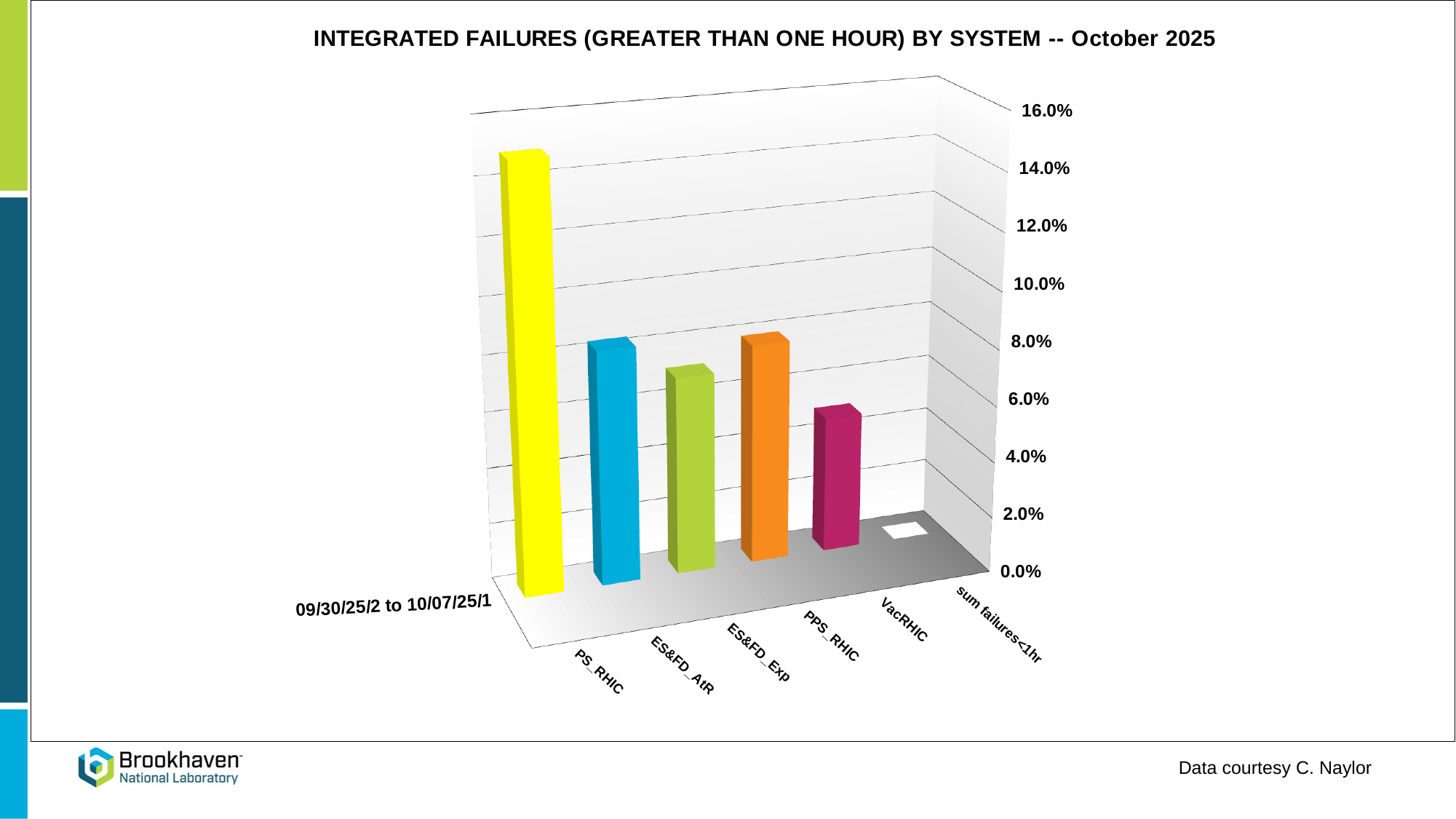
What kind of chart is shown on the slide? bar chart Which is larger, the value for ES&FD_AtR or the value for VacRHIC? ES&FD_AtR What date range is labelled on the chart's series axis? 09/30/25/2 to 10/07/25/1 How many system categories are plotted along the x axis? 6 Which category has the lowest value on the chart? sum failures<1hr Which is larger, the value for PS_RHIC or the value for VacRHIC? PS_RHIC Is the value for ES&FD_Exp greater or less than 4.0%? greater Which system has the highest integrated failure percentage? PS_RHIC Is the value for sum failures<1hr greater or less than 2.0%? less Is the value for PS_RHIC greater or less than 10.0%? greater What is the title of the chart? INTEGRATED FAILURES (GREATER THAN ONE HOUR) BY SYSTEM -- October 2025